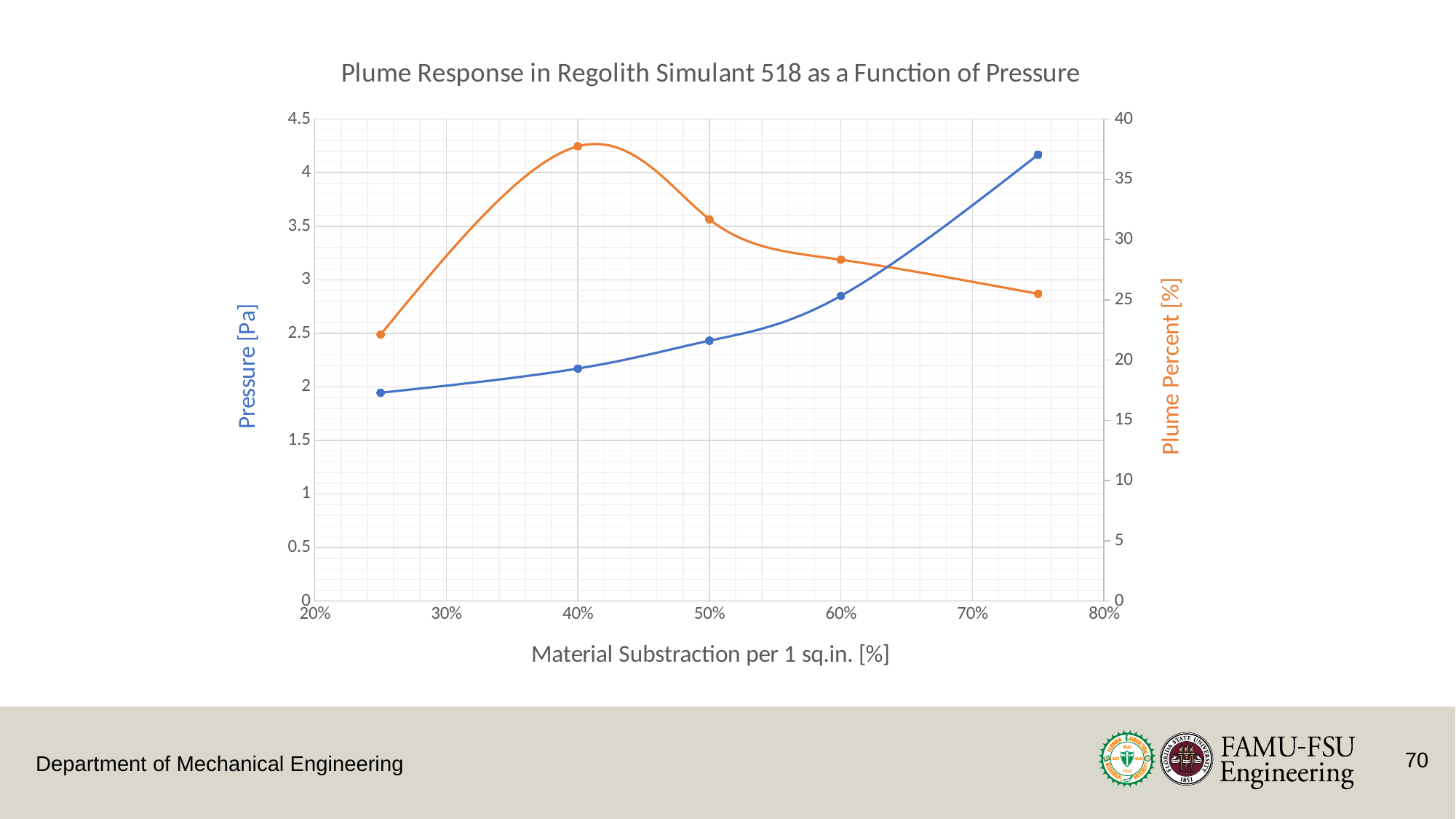
Is the Pressure [Pa] value at 25% Material Substraction greater or less than 2? less Does the Pressure [Pa] series rise or fall as Material Substraction increases? rises Is the Plume Percent [%] value at 40% Material Substraction greater or less than 35? greater How many data points does the Pressure [Pa] series have? 5 At which Material Substraction value is Pressure [Pa] highest? 75% What kind of chart is shown on the slide? line chart What is the label of the x axis? Material Substraction per 1 sq.in. [%] What is the title of the chart? Plume Response in Regolith Simulant 518 as a Function of Pressure At which Material Substraction value is Plume Percent [%] lowest? 25% Is the Pressure [Pa] value at 75% Material Substraction greater or less than 4? greater Which is larger, the Plume Percent [%] at 40% or at 50% Material Substraction? 40% At which Material Substraction value is Plume Percent [%] highest? 40%